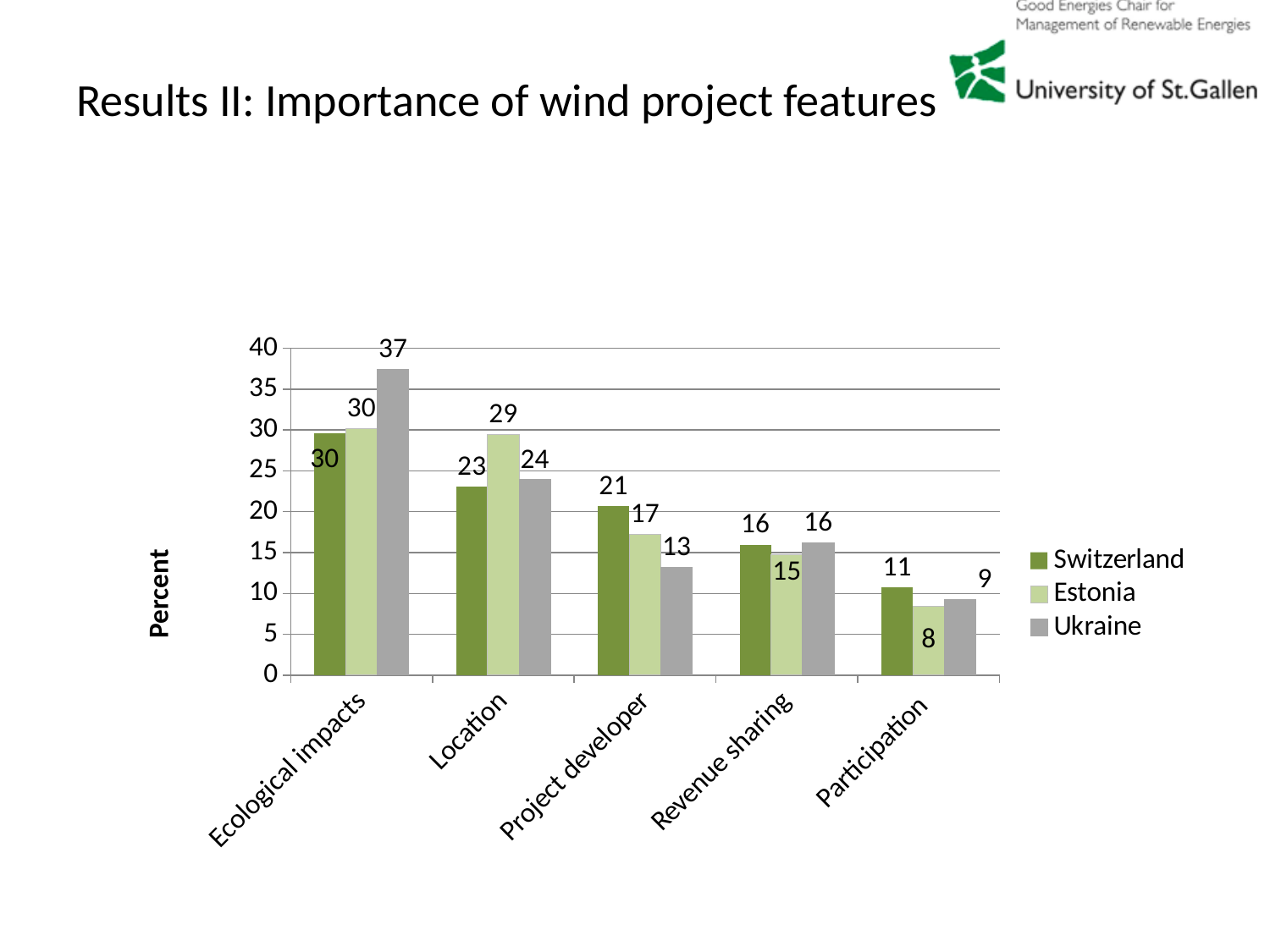
What is the label of the vertical axis? Percent How many series does the legend list? 3 What is the value for Ukraine for Ecological impacts? 37 What is the value for Estonia for Location? 29 What kind of chart is shown on the slide? Bar chart What is the difference between the Ukraine and Switzerland values for Ecological impacts? 7 For Project developer, which is larger: the value for Switzerland or the value for Ukraine? Switzerland Which category has the lowest value for Switzerland? Participation What is the value for Switzerland for Project developer? 21 How many categories are shown on the x axis? 5 What is the value for Estonia for Participation? 8 Which category has the highest value for Ukraine? Ecological impacts